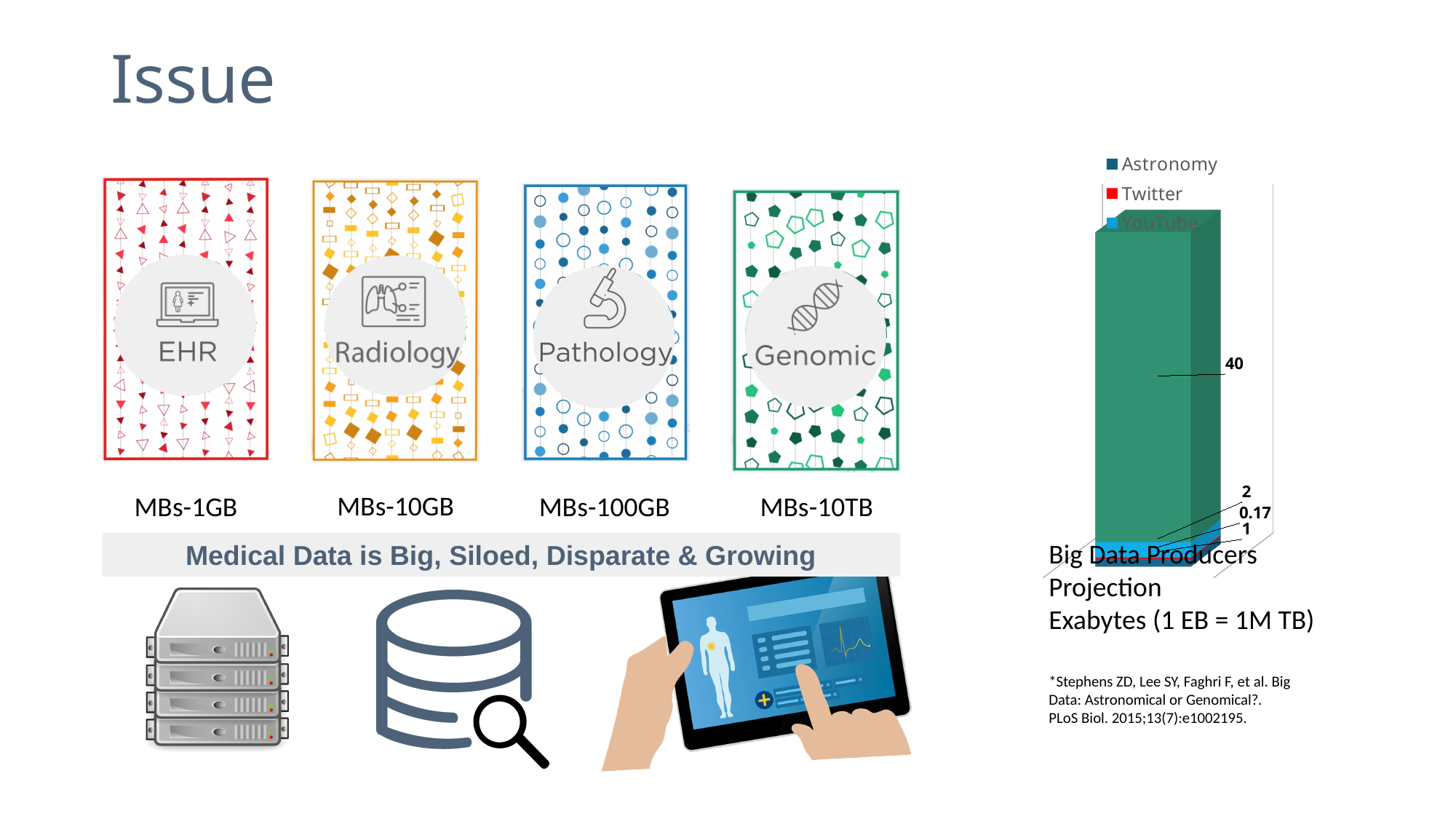
What is the smallest data label shown on the stacked bar in the Big Data Producers Projection chart? 0.17 What is the difference between the largest labelled segment (40) and the YouTube segment (2) in the Big Data Producers Projection chart? 38 What kind of chart is shown on the right side of the slide? bar chart In the Big Data Producers Projection chart, what value is labelled for the YouTube segment? 2 What is the largest data label shown on the stacked bar in the Big Data Producers Projection chart? 40 In the Big Data Producers Projection chart, what value is labelled for the Twitter (red) segment? 0.17 In what unit are the values of the Big Data Producers Projection chart expressed, according to the text below it? Exabytes In the Big Data Producers Projection chart, what value is labelled for the Astronomy segment at the bottom of the bar? 1 How many series does the visible legend of the Big Data Producers Projection chart list? 3 What colour represents Twitter in the legend of the Big Data Producers Projection chart? red In the Big Data Producers Projection chart, which is larger: the YouTube segment or the Twitter segment? YouTube What is the total of all labelled segments in the stacked bar of the Big Data Producers Projection chart? 43.17